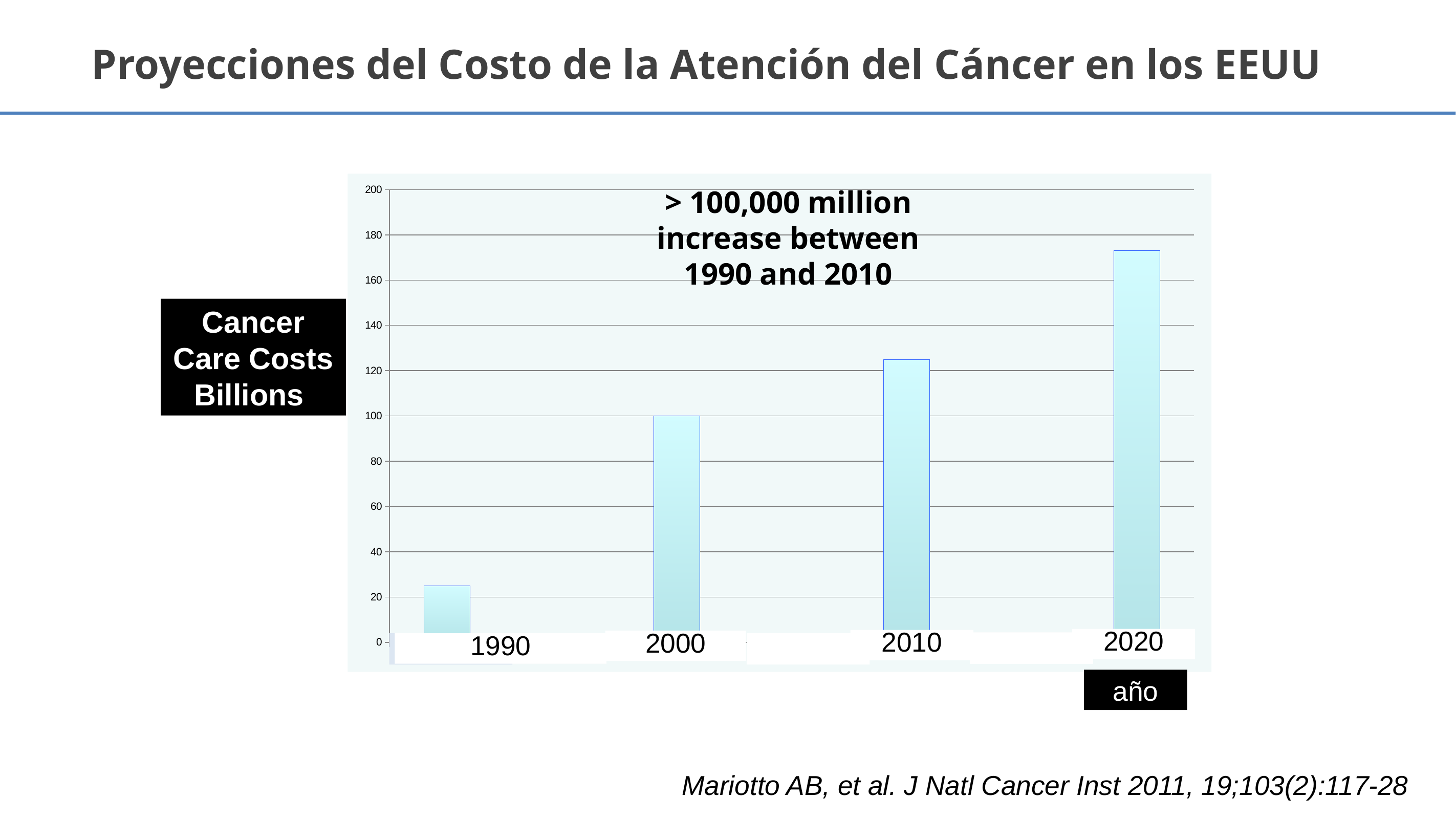
Which year has the lowest cancer care cost? 1990 What does the annotation inside the chart say the increase between 1990 and 2010 is? > 100,000 million Is the value for 2020 greater or less than 160? greater Is the value for 2010 greater or less than 120? greater Is the value for 1990 greater or less than 40? less Which is larger, the value for 2010 or the value for 2000? 2010 What is the label on the x axis of the chart? año What kind of chart is shown on the slide? bar chart What is the cancer care cost value for 2000? 100 Which year has the highest cancer care cost? 2020 Do the cancer care costs rise or fall from 1990 to 2020? rise How many years are plotted on the chart? 4